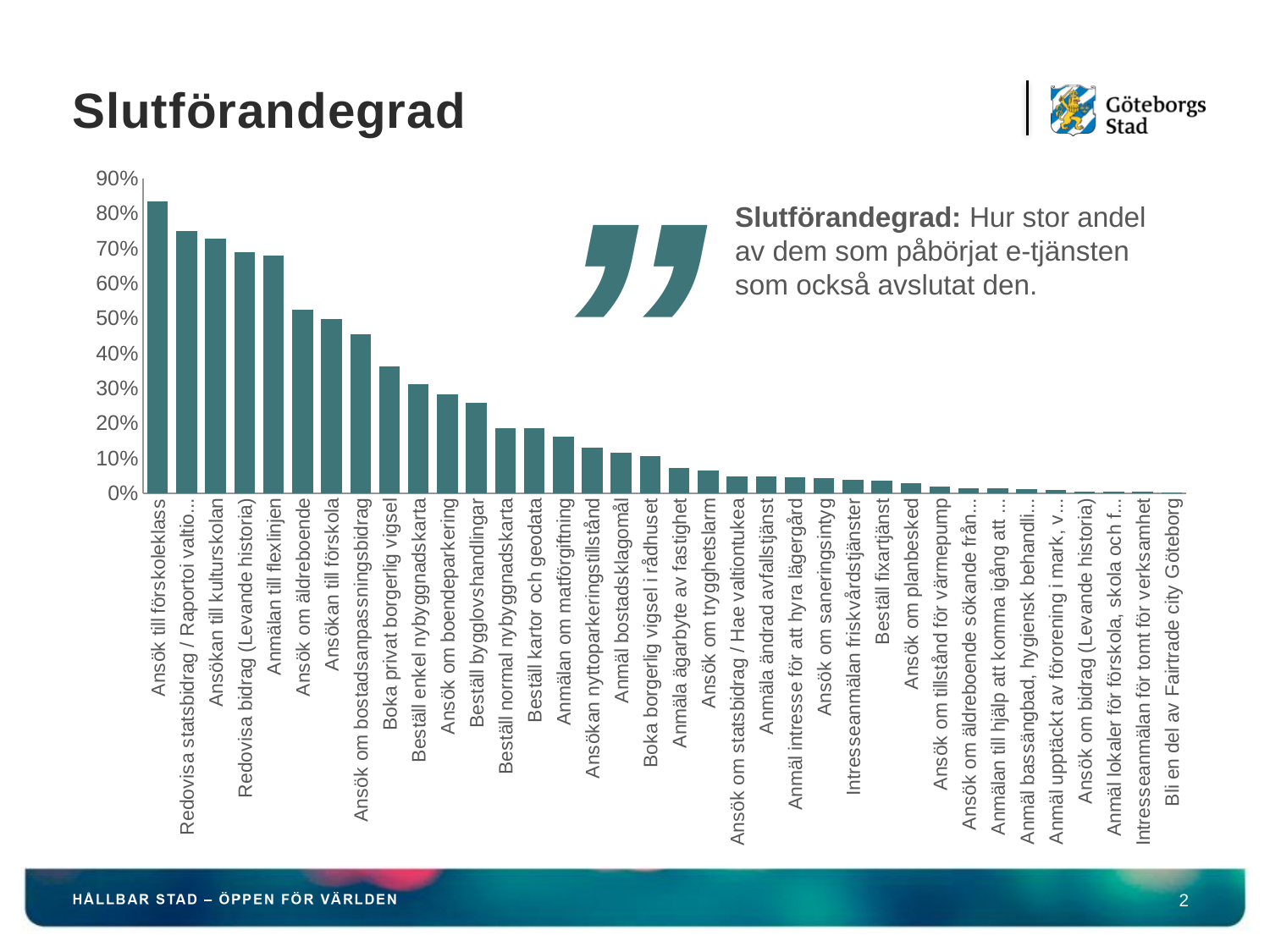
How many categories are plotted in the chart? 36 Is the value for Anmälan till flexlinjen greater or less than 70%? less Is the value for Boka privat borgerlig vigsel greater or less than 30%? greater Which category has the highest value in the chart? Ansök till förskoleklass Which is larger, the value for Beställ bygglovshandlingar or the value for Anmälan om matförgiftning? Beställ bygglovshandlingar What is the title of the chart on the slide? Slutförandegrad Is the value for Ansök till förskoleklass greater or less than 80%? greater Do the values rise or fall from left to right along the x axis? Fall What kind of chart is shown on the slide? Bar chart Which is larger, the value for Ansökan till kulturskolan or the value for Redovisa bidrag (Levande historia)? Ansökan till kulturskolan